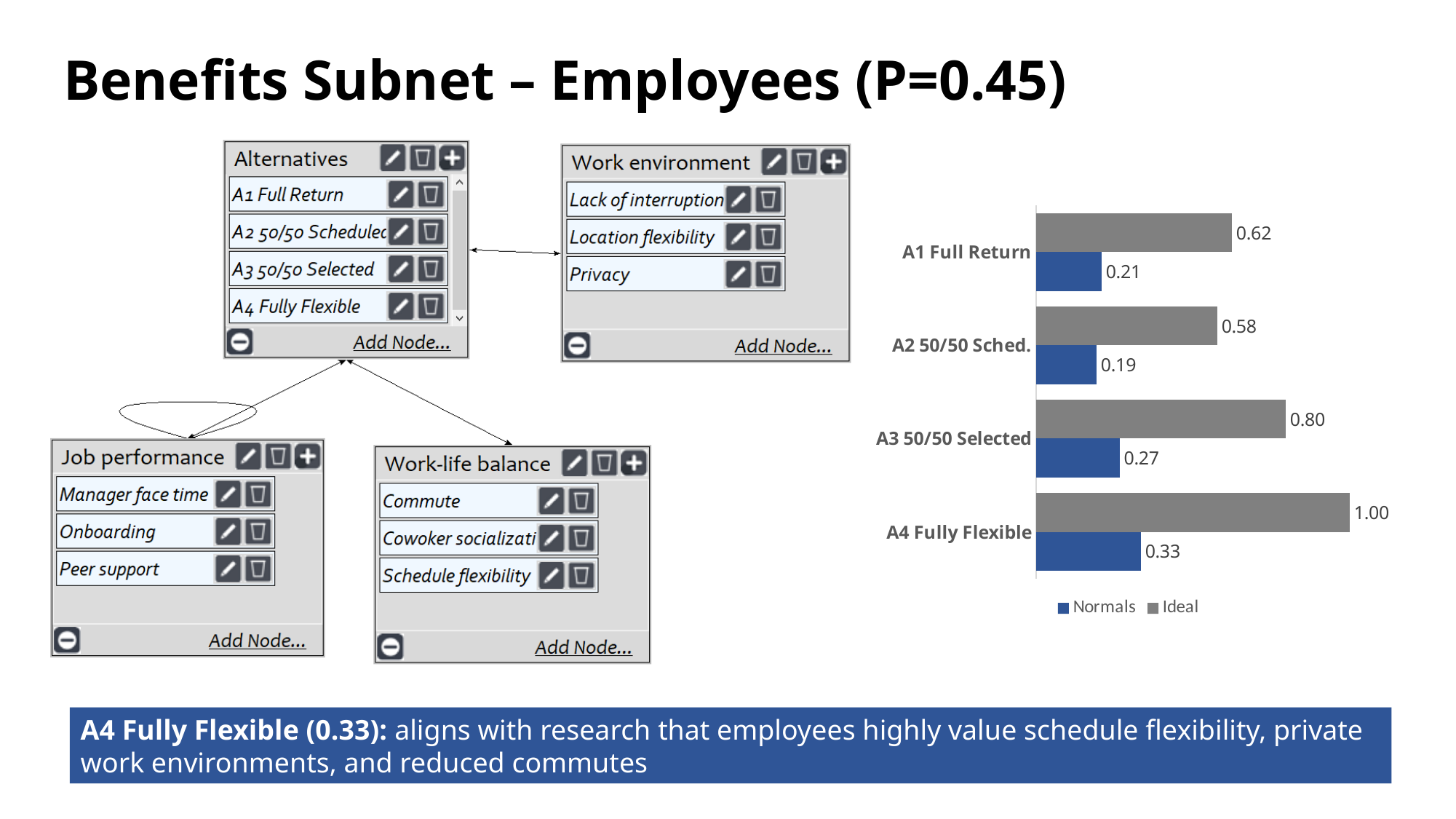
Which is larger, the Normals value for A1 Full Return or for A2 50/50 Sched.? A1 Full Return Which colour represents the Ideal series in the chart? Grey How many alternatives are shown on the bar chart? 4 Which alternative has the lowest Ideal value? A2 50/50 Sched. What is the Ideal value for A2 50/50 Sched.? 0.58 How many series does the chart legend list? 2 What is the Ideal value for A4 Fully Flexible? 1.00 What is the Normals value for A1 Full Return? 0.21 What is the Normals value for A3 50/50 Selected? 0.27 What is the difference between the Ideal values for A4 Fully Flexible and A3 50/50 Selected? 0.20 What kind of chart is shown on the right of the slide? Bar chart Which alternative has the highest Normals value? A4 Fully Flexible